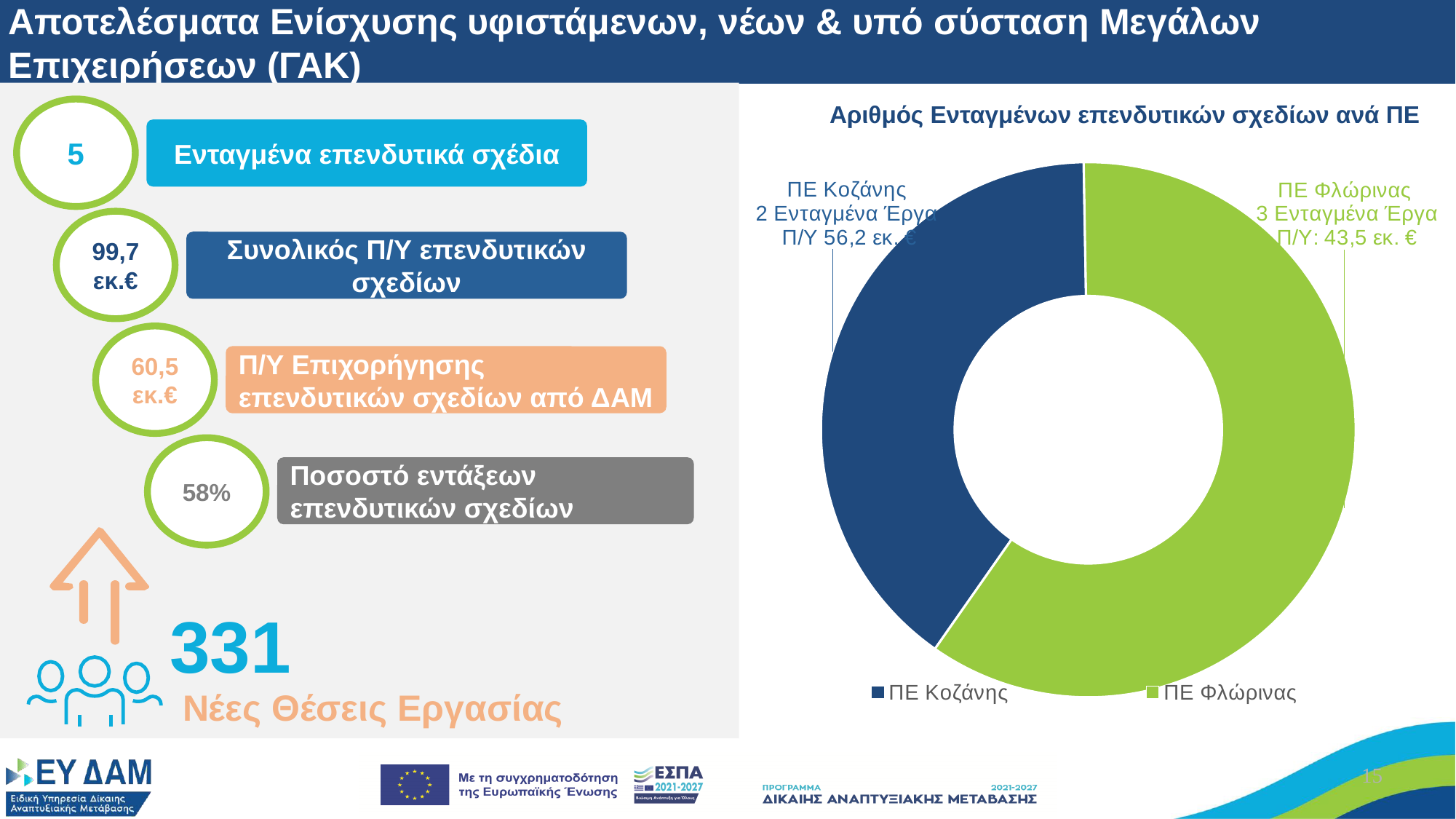
How many approved projects (Ενταγμένα Έργα) does the chart show for ΠΕ Κοζάνης? 2 What is the difference in the number of approved projects between ΠΕ Φλώρινας and ΠΕ Κοζάνης? 1 What budget (Π/Υ) is shown on the chart for ΠΕ Κοζάνης? 56,2 εκ. € How many entries does the chart legend list? 2 How many slices does the doughnut chart have? 2 What is the title of the chart on the slide? Αριθμός Ενταγμένων επενδυτικών σχεδίων ανά ΠΕ What kind of chart is shown on the right side of the slide? doughnut chart How many approved projects (Ενταγμένα Έργα) does the chart show for ΠΕ Φλώρινας? 3 Which regional unit has the smaller number of approved projects in the chart? ΠΕ Κοζάνης Which regional unit has the larger number of approved projects in the chart? ΠΕ Φλώρινας What share of the total approved projects in the chart belongs to ΠΕ Φλώρινας? 60% What budget (Π/Υ) is shown on the chart for ΠΕ Φλώρινας? 43,5 εκ. €